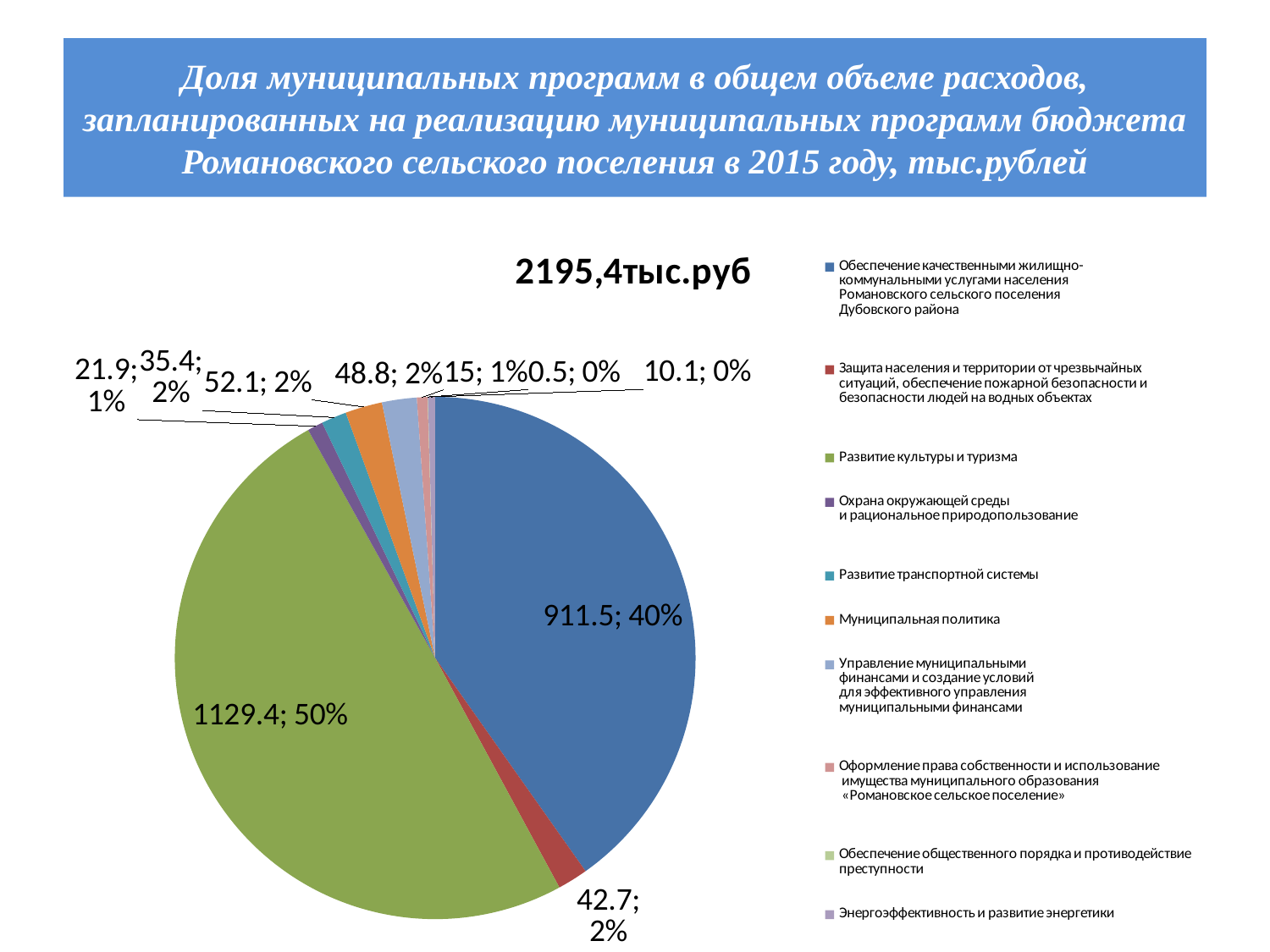
How many slices does the pie chart have? 10 Which is larger: the value for Муниципальная политика or the value for Управление муниципальными финансами и создание условий для эффективного управления муниципальными финансами? Муниципальная политика What is the value for Развитие культуры и туризма? 1129.4 What is the value for Защита населения и территории от чрезвычайных ситуаций, обеспечение пожарной безопасности и безопасности людей на водных объектах? 42.7 What is the difference between the values for Развитие культуры и туризма and Обеспечение качественными жилищно-коммунальными услугами населения? 217.9 What is the value for Обеспечение качественными жилищно-коммунальными услугами населения Романовского сельского поселения Дубовского района? 911.5 Which category has the largest slice of the pie? Развитие культуры и туризма Which category has the smallest slice of the pie? Обеспечение общественного порядка и противодействие преступности What share of the pie does Развитие культуры и туризма take? 50% What total amount is printed above the pie chart? 2195,4тыс.руб How many entries does the legend list? 10 What kind of chart is shown on the slide? pie chart